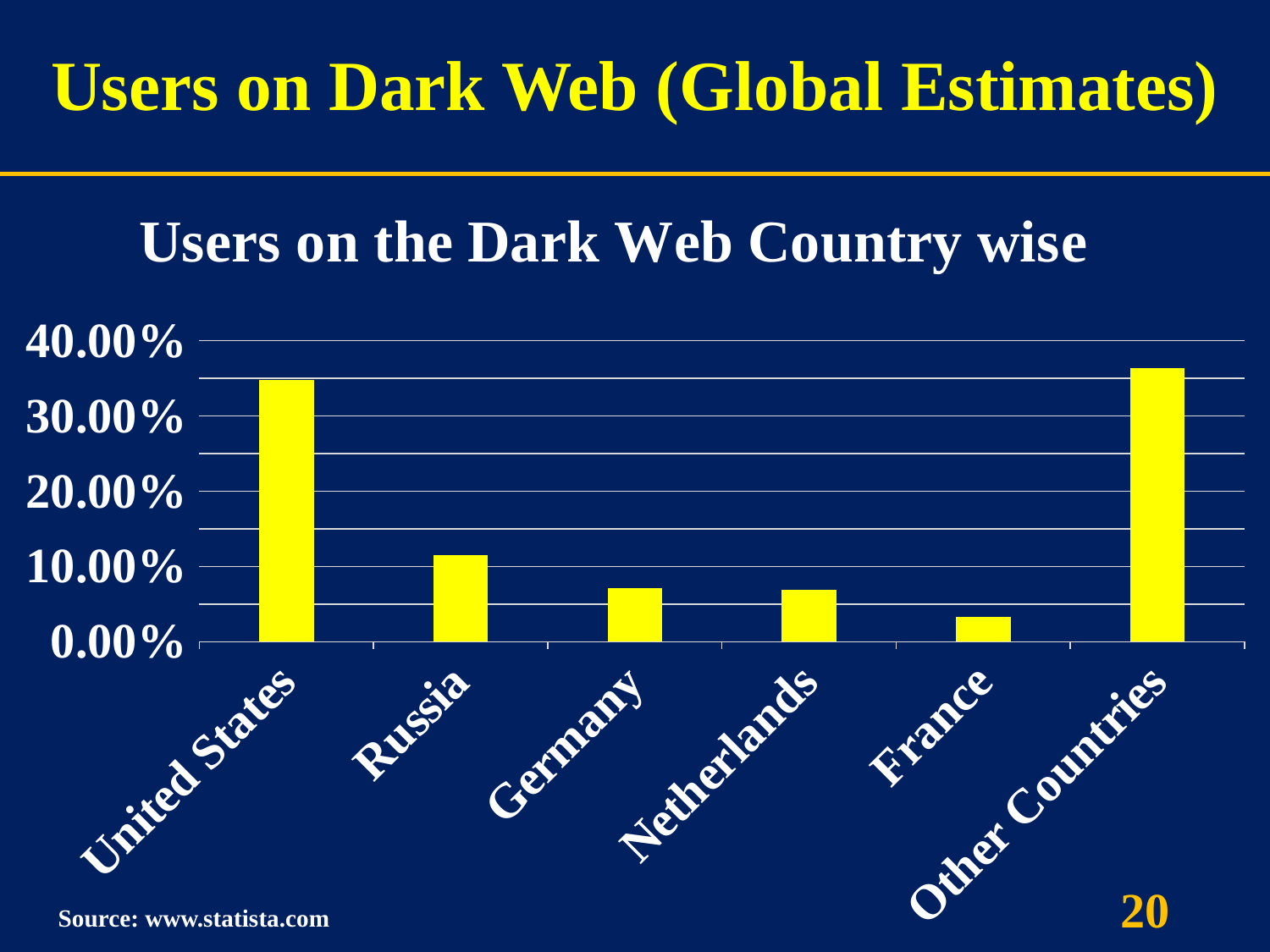
Is the value for Russia greater or less than 10.00%? greater Is the value for Germany greater or less than 10.00%? less Is the value for United States greater or less than 30.00%? greater What is the title of the chart? Users on the Dark Web Country wise Which category has the tallest bar in the chart? Other Countries What kind of chart is shown on the slide? bar chart Which has a larger share of dark web users, United States or Germany? United States Which category has the lowest share of users on the dark web? France Which has a larger share of dark web users, Russia or France? Russia How many countries or categories are shown on the x axis of the chart? 6